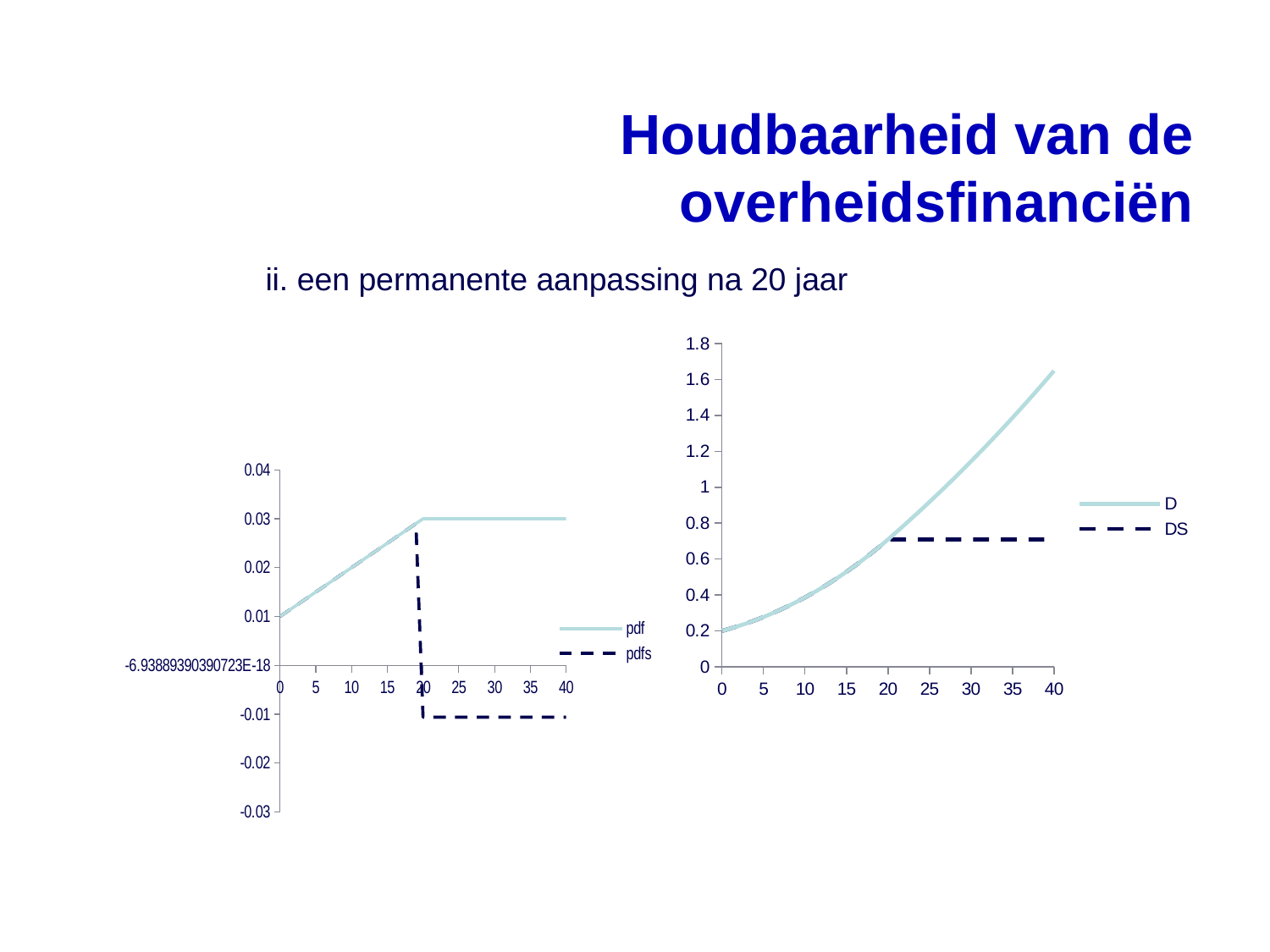
In the right chart, is the value of DS at year 35 greater or less than 1? less In the left chart, which series is higher at year 30, pdf or pdfs? pdf How many series does the legend of the left chart list? 2 In the right chart, which series is higher at year 35, D or DS? D What type of chart is the right chart with the D and DS series? line chart In the left chart, what value does the pdf series stay at from year 20 to year 40? 0.03 In the right chart, does the D series rise or fall as the x axis goes from 0 to 40? rise What type of chart is the left chart with the pdf and pdfs series? line chart How many series does the legend of the right chart list? 2 In the right chart, is the value of D at year 40 greater or less than 1.4? greater In the right chart, which series is drawn with a dashed line? DS